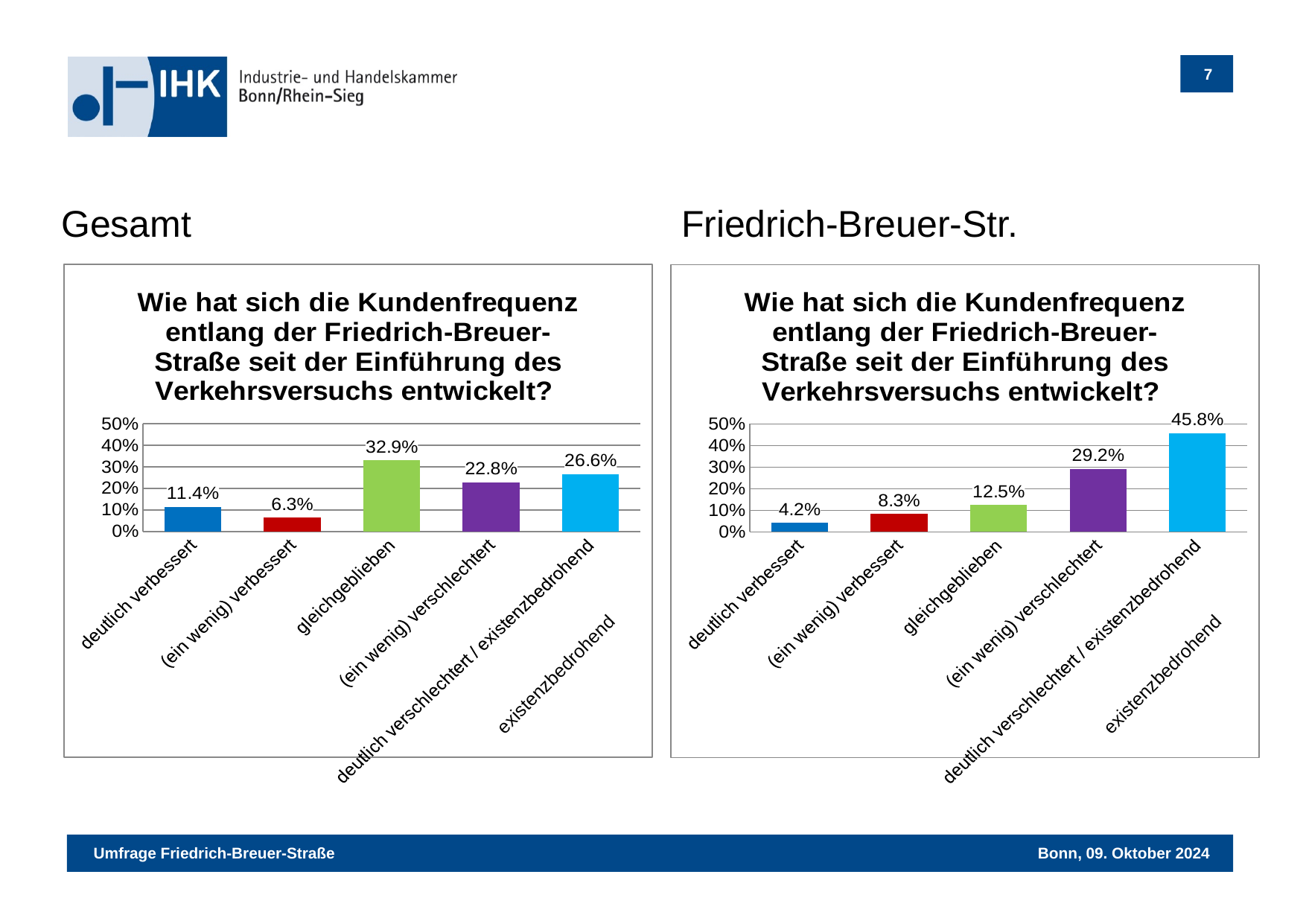
In the Friedrich-Breuer-Str. chart on the right, what is the value for deutlich verschlechtert / existenzbedrohend? 45.8% In the Gesamt chart on the left, what is the value for (ein wenig) verbessert? 6.3% In the Friedrich-Breuer-Str. chart on the right, what is the difference between the values for deutlich verschlechtert / existenzbedrohend and (ein wenig) verschlechtert? 16.6% In the Friedrich-Breuer-Str. chart on the right, what is the value for deutlich verbessert? 4.2% In the Friedrich-Breuer-Str. chart on the right, which is larger: the value for gleichgeblieben or the value for (ein wenig) verschlechtert? (ein wenig) verschlechtert In the Friedrich-Breuer-Str. chart on the right, which category has the lowest value? deutlich verbessert In the Gesamt chart on the left, what is the value for gleichgeblieben? 32.9% How many categories are shown in the Gesamt chart on the left? 5 In the Gesamt chart on the left, which category has the highest value? gleichgeblieben In the Friedrich-Breuer-Str. chart on the right, do the values rise or fall from left to right along the x axis? rise In the Gesamt chart on the left, what is the difference between the values for gleichgeblieben and deutlich verschlechtert / existenzbedrohend? 6.3% What kind of chart is the Friedrich-Breuer-Str. chart on the right? bar chart